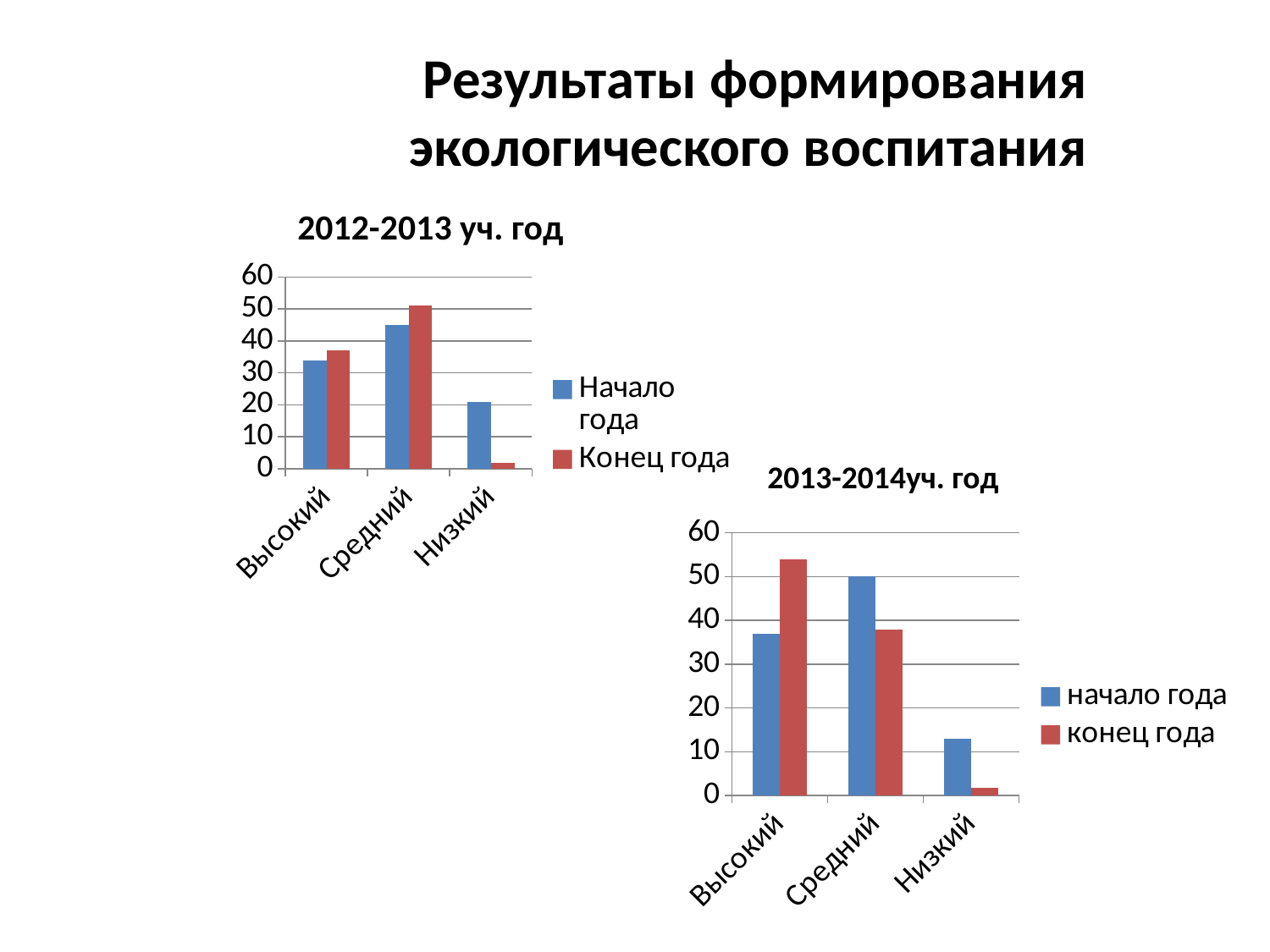
In the chart titled "2012-2013 уч. год", which category has the highest value for "Конец года"? Средний In the chart titled "2013-2014уч. год", which category has the highest value for "конец года"? Высокий In the chart titled "2012-2013 уч. год", which category has the lowest value for "Начало года"? Низкий In the chart titled "2012-2013 уч. год", what kind of chart is shown? bar chart In the chart titled "2012-2013 уч. год", is the "Начало года" value for Низкий greater or less than 30? less In the chart titled "2013-2014уч. год", is the "конец года" value for Высокий greater or less than 50? greater In the chart titled "2012-2013 уч. год", how many categories are shown on the x axis? 3 In the chart titled "2012-2013 уч. год", what colour are the bars for "Конец года"? red In the chart titled "2013-2014уч. год", is the "начало года" value for Низкий greater or less than 20? less In the chart titled "2013-2014уч. год", how many series does the legend list? 2 In the chart titled "2013-2014уч. год", which is larger for Средний: "начало года" or "конец года"? начало года